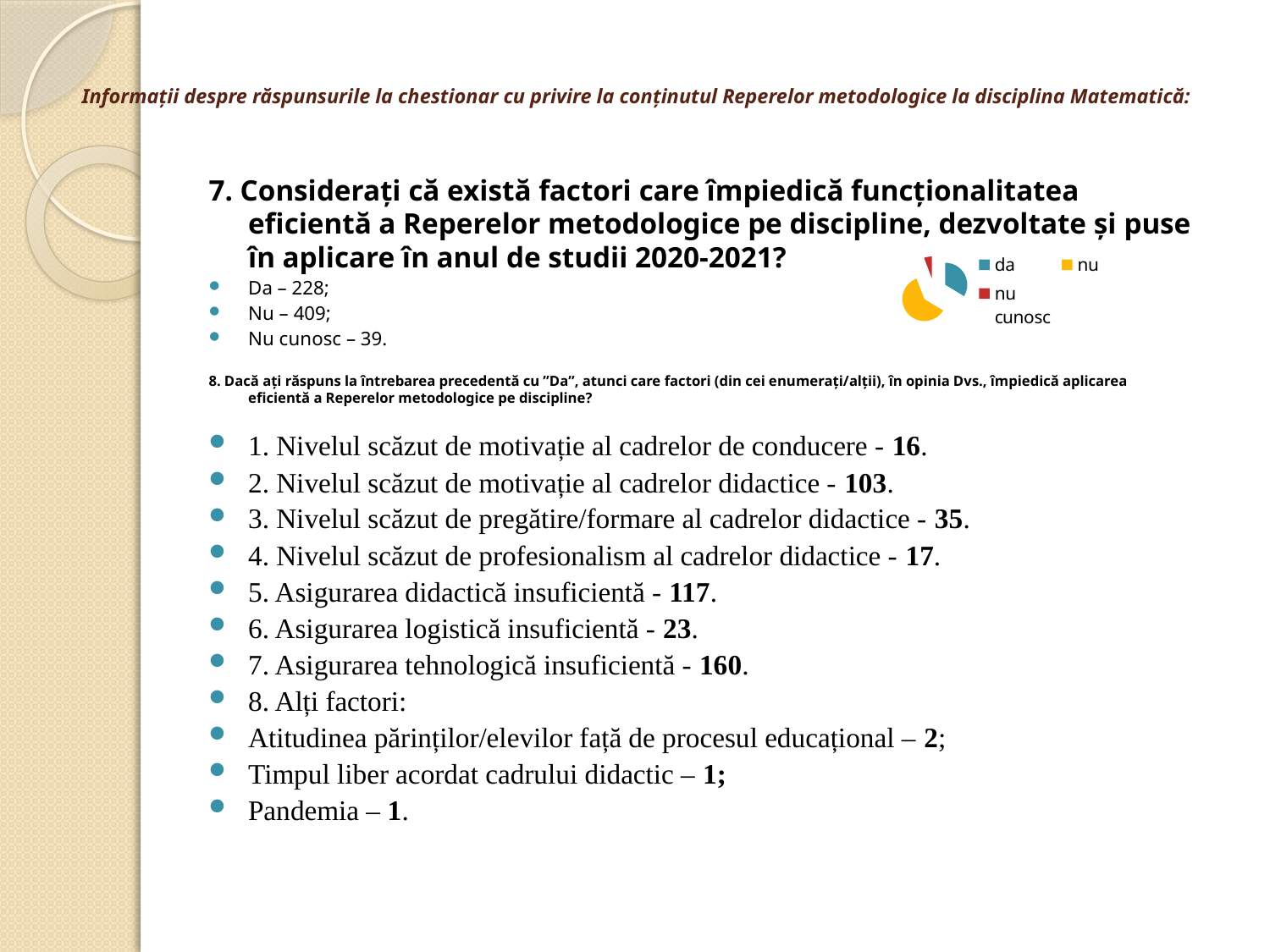
Which category has the smallest slice in the pie chart? nu cunosc According to the slide, how many respondents answered 'Nu cunosc' to question 7? 39 What are the legend entries of the pie chart? da, nu, nu cunosc What kind of chart is shown on the slide? pie chart Which slice is larger in the pie chart, 'da' or 'nu'? nu How many categories does the pie chart's legend list? 3 Which slice is larger in the pie chart, 'da' or 'nu cunosc'? da What colour is the 'nu' slice in the pie chart? yellow According to the slide, how many respondents answered 'Nu' to question 7? 409 According to the slide, how many respondents answered 'Da' to question 7? 228 By how much does the number of 'Nu' answers exceed the number of 'Da' answers for question 7? 181 Which category has the largest slice in the pie chart? nu